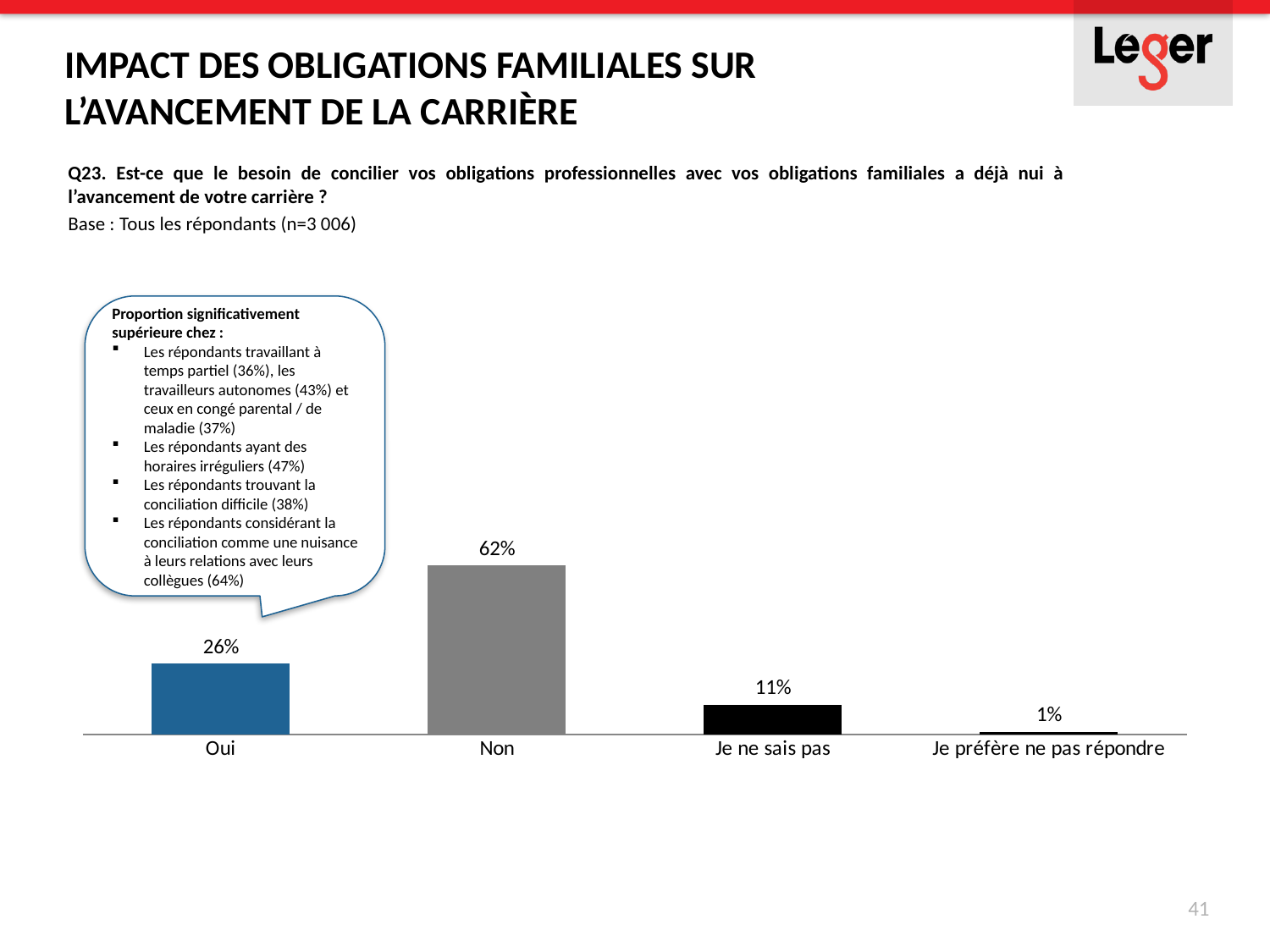
What is the value for "Je ne sais pas"? 11% How many categories are shown on the chart? 4 What kind of chart is shown on the slide? Bar chart Which is larger, the value for "Oui" or the value for "Je ne sais pas"? Oui What is the difference between the values for "Oui" and "Je ne sais pas"? 15% Which category has the highest value? Non What colour is the bar for "Oui"? Blue Which category has the lowest value? Je préfère ne pas répondre What is the value for "Non"? 62% What is the value for "Je préfère ne pas répondre"? 1% What is the difference between the values for "Non" and "Oui"? 36% What is the value for "Oui"? 26%